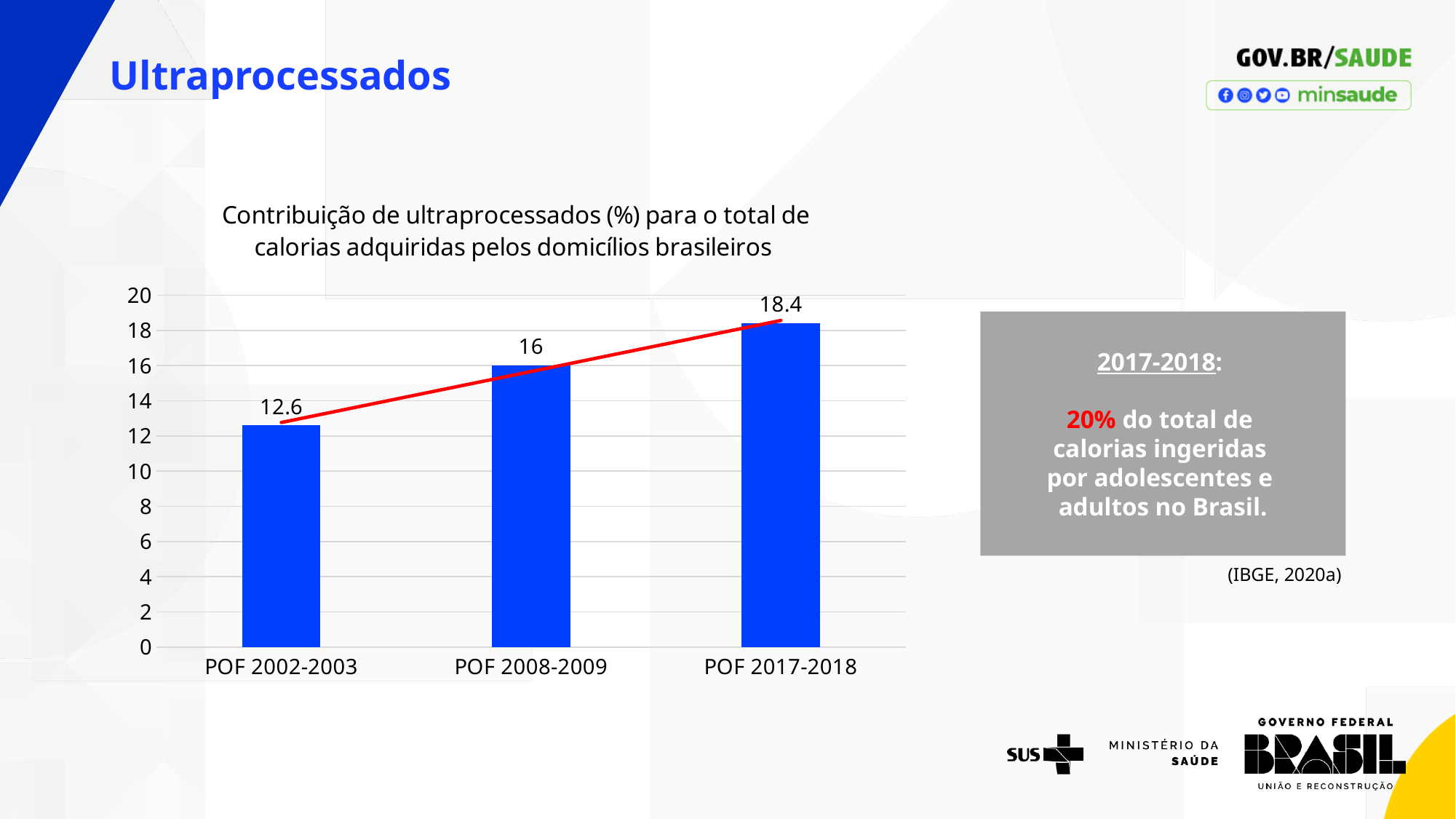
Is the value for POF 2017-2018 greater or less than 18? greater Which category has the lowest value? POF 2002-2003 What is the value for POF 2008-2009? 16 What is the difference between the values for POF 2008-2009 and POF 2002-2003? 3.4 What is the difference between the values for POF 2017-2018 and POF 2002-2003? 5.8 How many categories are shown on the x axis? 3 What is the value for POF 2017-2018? 18.4 Which category has the highest value? POF 2017-2018 Which is larger, the value for POF 2008-2009 or POF 2002-2003? POF 2008-2009 What kind of chart is shown on the slide? bar chart Do the values rise or fall from POF 2002-2003 to POF 2017-2018? rise What is the value for POF 2002-2003? 12.6